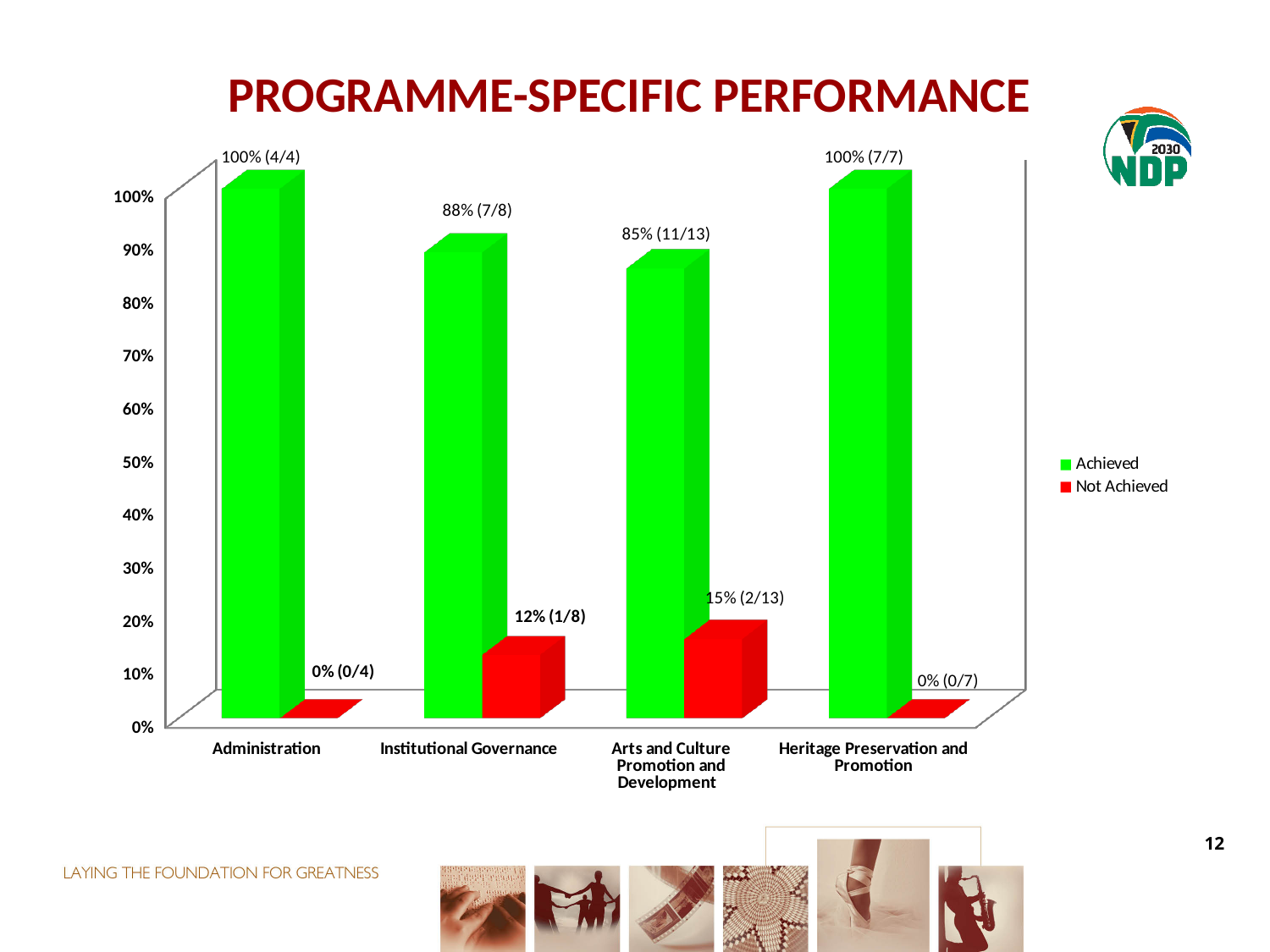
What is the title of the chart? PROGRAMME-SPECIFIC PERFORMANCE What is the Not Achieved value for Arts and Culture Promotion and Development? 15% (2/13) Is the Achieved percentage for Institutional Governance greater or less than the Achieved percentage for Arts and Culture Promotion and Development? greater How many series does the legend list? 2 Which programme has the highest Not Achieved percentage? Arts and Culture Promotion and Development What is the Achieved value for Institutional Governance? 88% (7/8) What is the difference in Achieved percentage between Administration and Institutional Governance? 12% Which programme has the lowest Achieved percentage? Arts and Culture Promotion and Development What kind of chart is shown on the slide? bar chart What is the Achieved value for Heritage Preservation and Promotion? 100% (7/7) How many programmes are shown on the x axis? 4 What is the Not Achieved value for Administration? 0% (0/4)